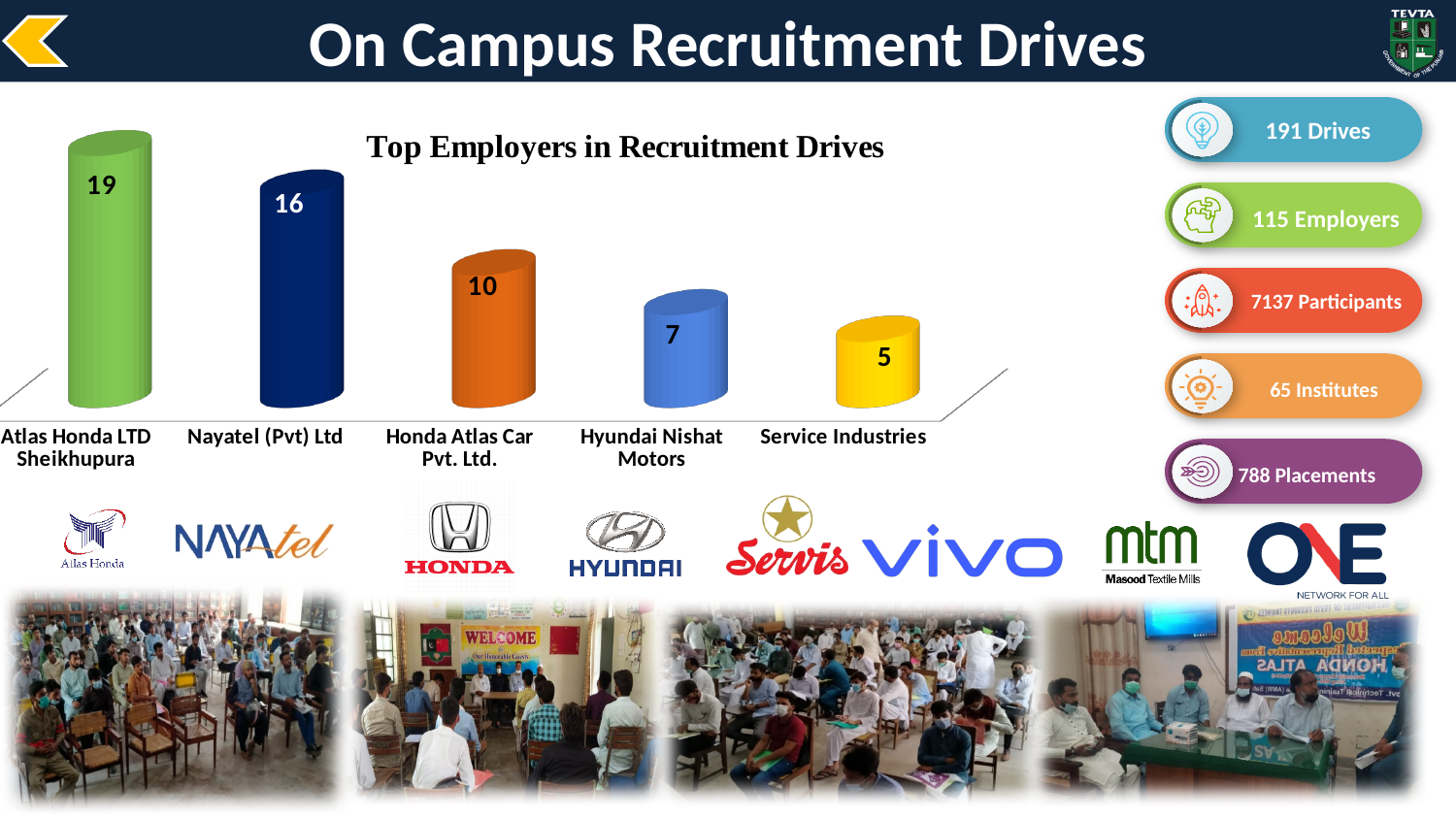
How many employers are shown in the chart? 5 What is the value for Atlas Honda LTD Sheikhupura in the Top Employers in Recruitment Drives chart? 19 What is the difference between the values for Atlas Honda LTD Sheikhupura and Nayatel (Pvt) Ltd? 3 What is the value for Nayatel (Pvt) Ltd in the chart? 16 Which employer has the highest value in the chart? Atlas Honda LTD Sheikhupura What is the value for Honda Atlas Car Pvt. Ltd. in the chart? 10 What kind of chart is shown on the slide? Bar chart Which employer has the lowest value in the chart? Service Industries What is the value for Service Industries in the chart? 5 Which is larger, the value for Honda Atlas Car Pvt. Ltd. or the value for Hyundai Nishat Motors? Honda Atlas Car Pvt. Ltd. What is the value for Hyundai Nishat Motors in the chart? 7 What is the title of the chart? Top Employers in Recruitment Drives